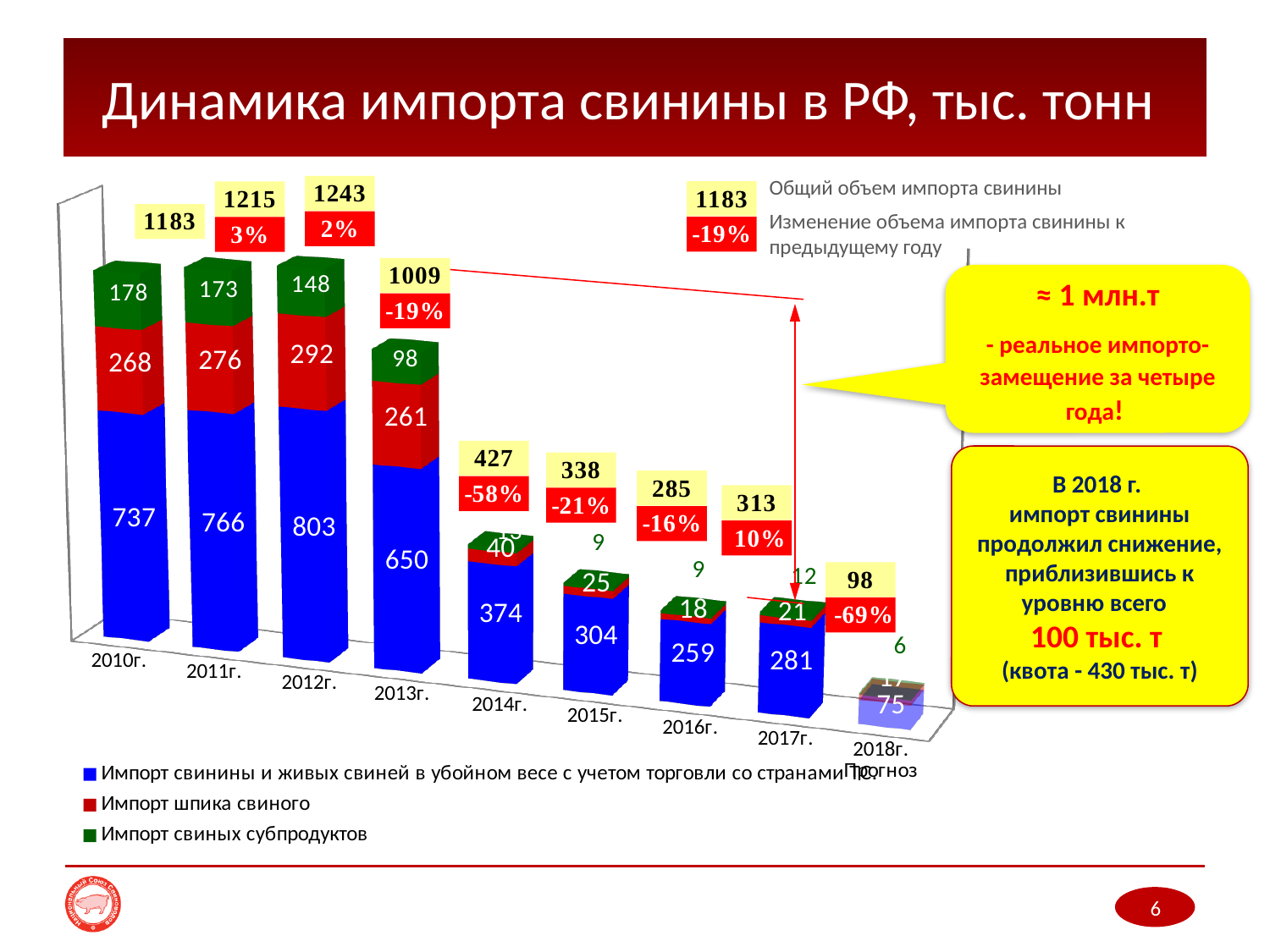
What is the difference between the red series (Импорт шпика свиного) values for 2012г. and 2010г.? 24 What is the value of the green series (Импорт свиных субпродуктов) for 2013г.? 98 How many years are shown along the x axis? 9 What is the change in import volume compared to the previous year shown for 2014г.? -58% How many series does the legend list? 3 What is the value of the blue series (Импорт свинины и живых свиней) for 2012г.? 803 What is the total pork import volume (Общий объем импорта свинины) for 2013г.? 1009 Which is larger, the green series (Импорт свиных субпродуктов) value for 2010г. or for 2011г.? 2010г. What kind of chart is shown on the slide? bar chart Which year has the lowest total pork import volume? 2018г. Do the total pork import volumes rise or fall from 2012г. to 2018г.? fall Which year has the highest total pork import volume? 2012г.